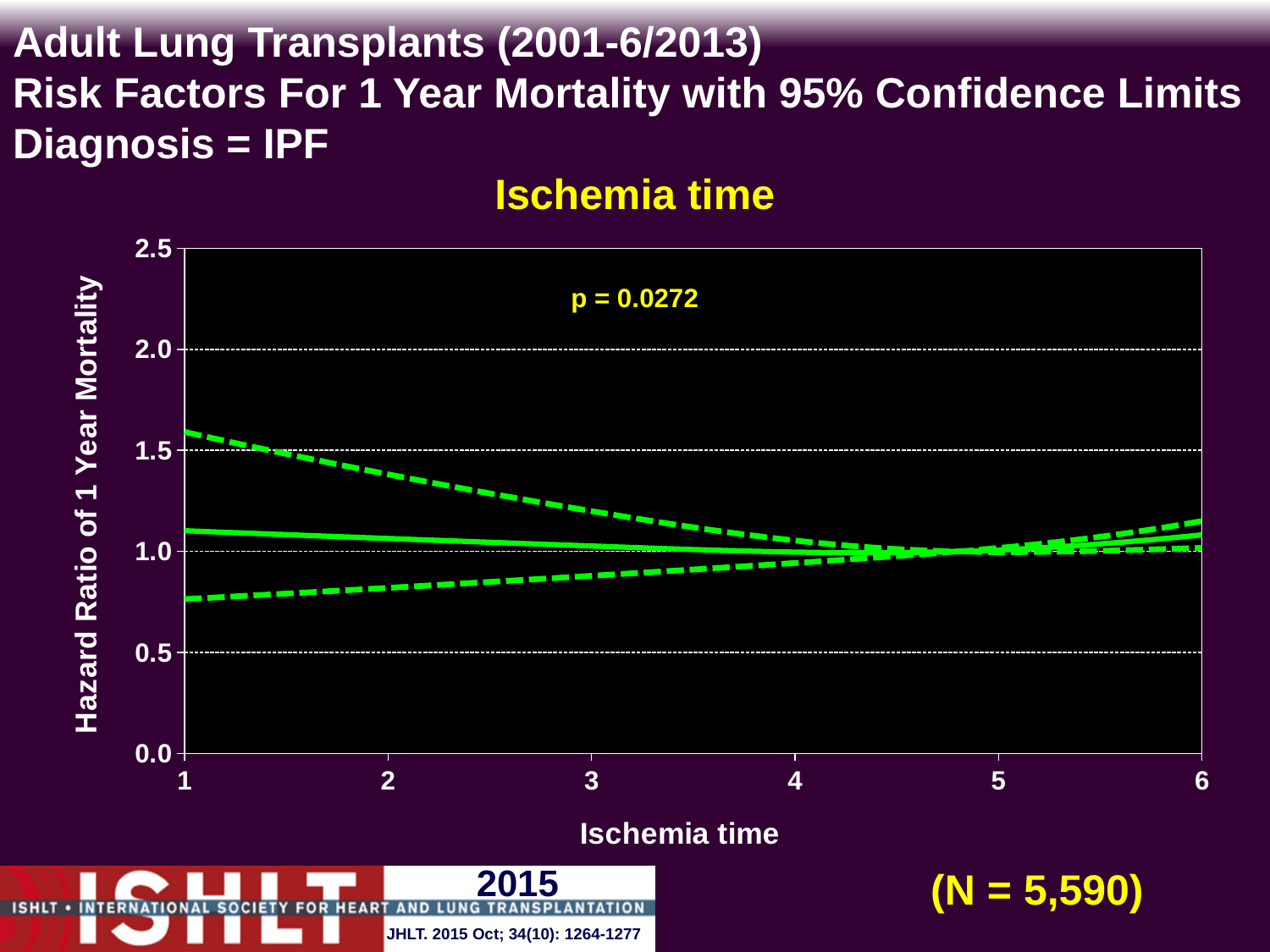
Is the value of the solid hazard ratio line at ischemia time 1 greater or less than 1.0? greater Is the value of the lower dashed confidence limit at ischemia time 1 greater or less than 0.5? greater Is the value of the upper dashed confidence limit at ischemia time 6 greater or less than 1.5? less What sample size (N) is shown on the slide? N = 5,590 How many tick values are labelled on the x axis (Ischemia time)? 6 What p-value is printed on the chart? p = 0.0272 Does the upper dashed confidence limit rise or fall as ischemia time increases from 1 to 4? fall How many lines are plotted on the chart? 3 What is the highest value labelled on the y axis? 2.5 What kind of chart is shown on the slide? line chart Does the lower dashed confidence limit rise or fall as ischemia time increases from 1 to 4? rise